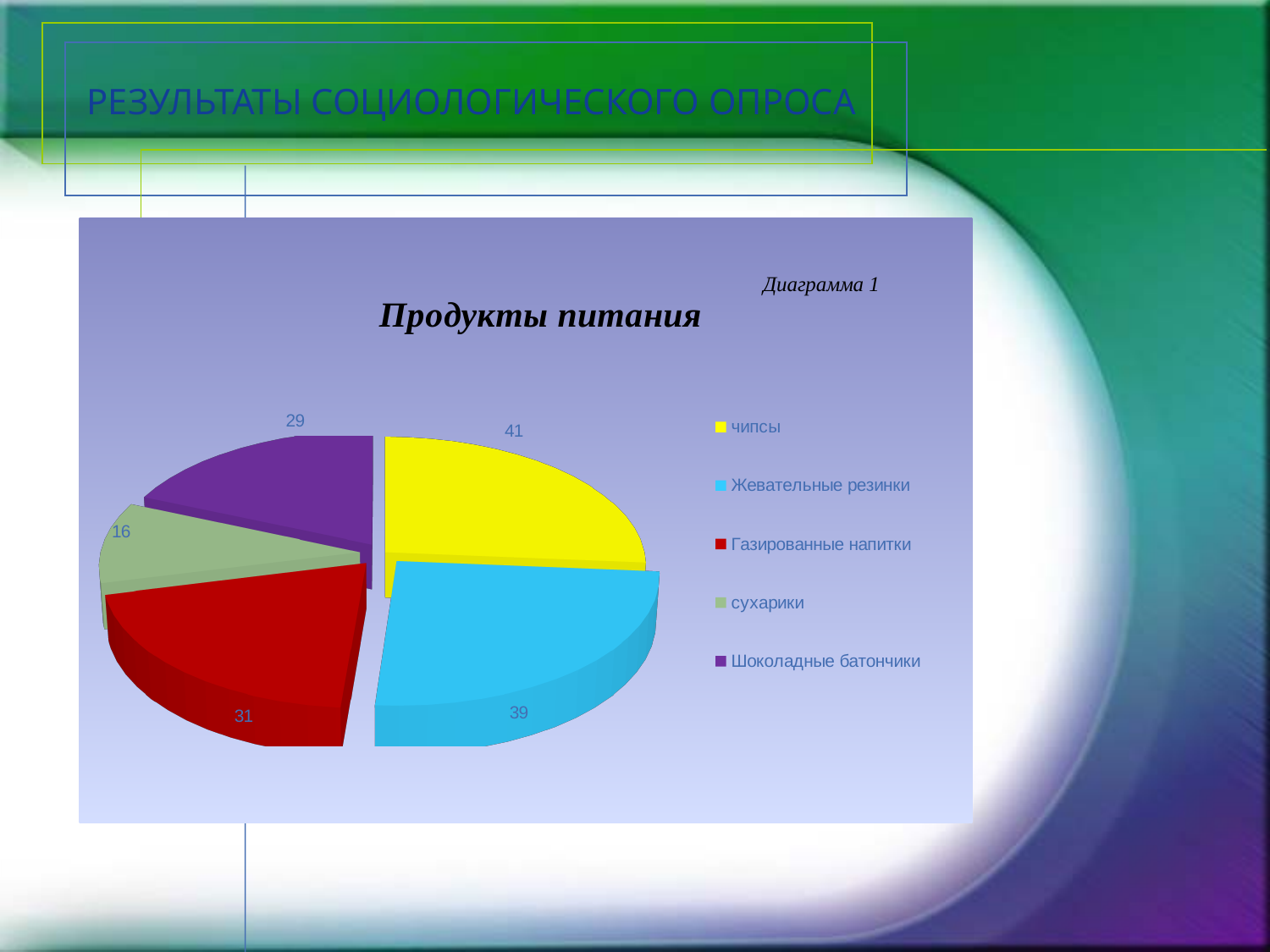
What is the value for Шоколадные батончики? 29 Which category has the smallest slice? сухарики What is the difference between the values for чипсы and сухарики? 25 What is the value for Жевательные резинки? 39 Which category has the largest slice? чипсы How many categories does the legend list? 5 What type of chart is shown on the slide? pie chart What is the title of the chart? Продукты питания What is the value for чипсы? 41 Which is larger, the value for Газированные напитки or the value for Шоколадные батончики? Газированные напитки What is the value for Газированные напитки? 31 What is the value for сухарики? 16